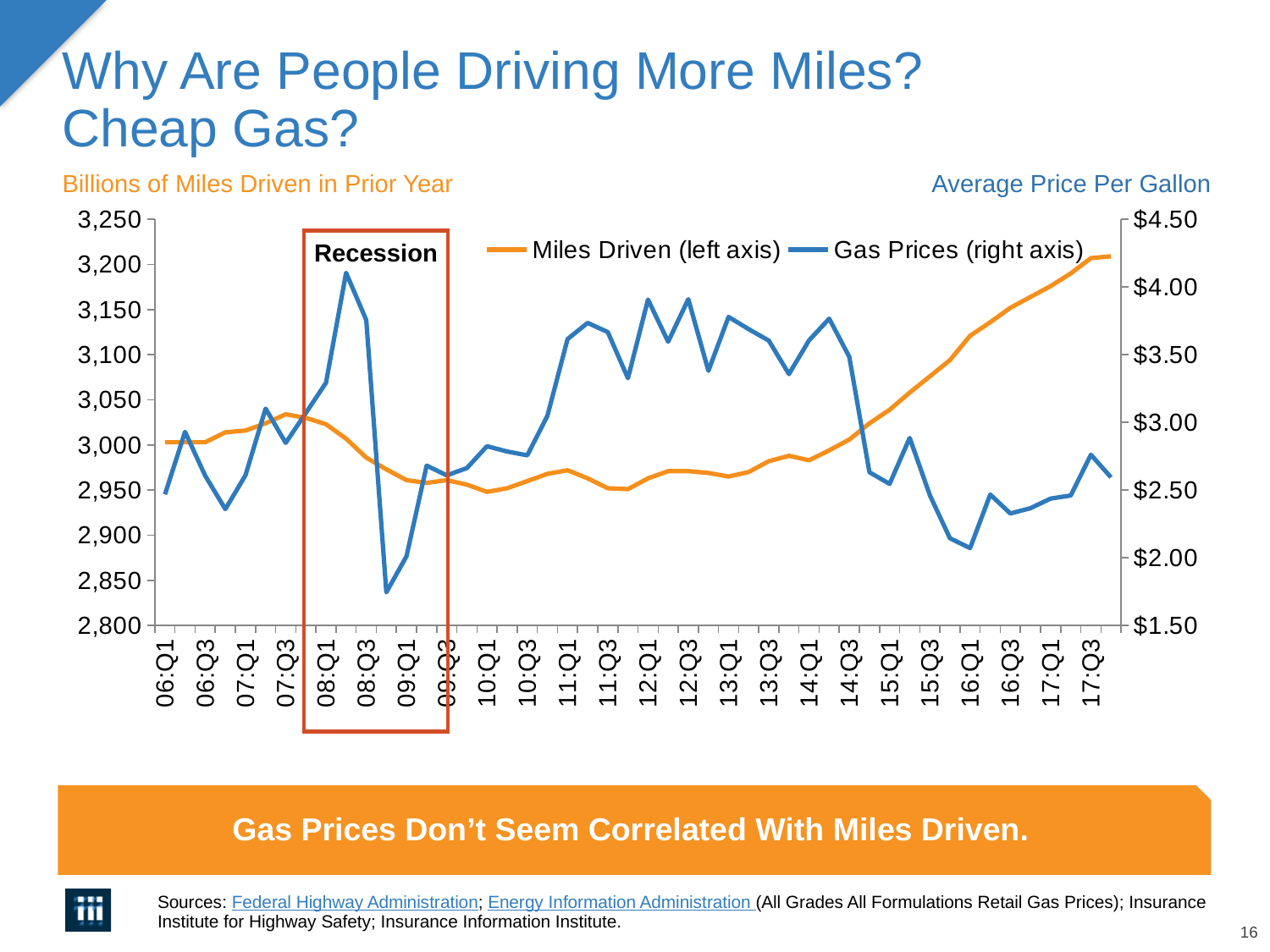
Is the Miles Driven value at 10:Q1 greater or less than 3,000? less Does the Miles Driven line rise or fall from 14:Q1 to 17:Q3? rise How many series does the legend list? 2 Is the Miles Driven value at 17:Q3 greater or less than 3,150? greater What kind of chart is shown on the slide? Line chart Is the Gas Prices value at its 2008 peak greater or less than $4.00? greater At which end of the x axis does the Miles Driven line reach its highest value? The right end Around which quarter does the Gas Prices line reach its highest point? 08:Q2 Around which quarter does the Gas Prices line reach its lowest point? 08:Q4 Which series is plotted against the right axis? Gas Prices What period does the red box on the chart mark? Recession